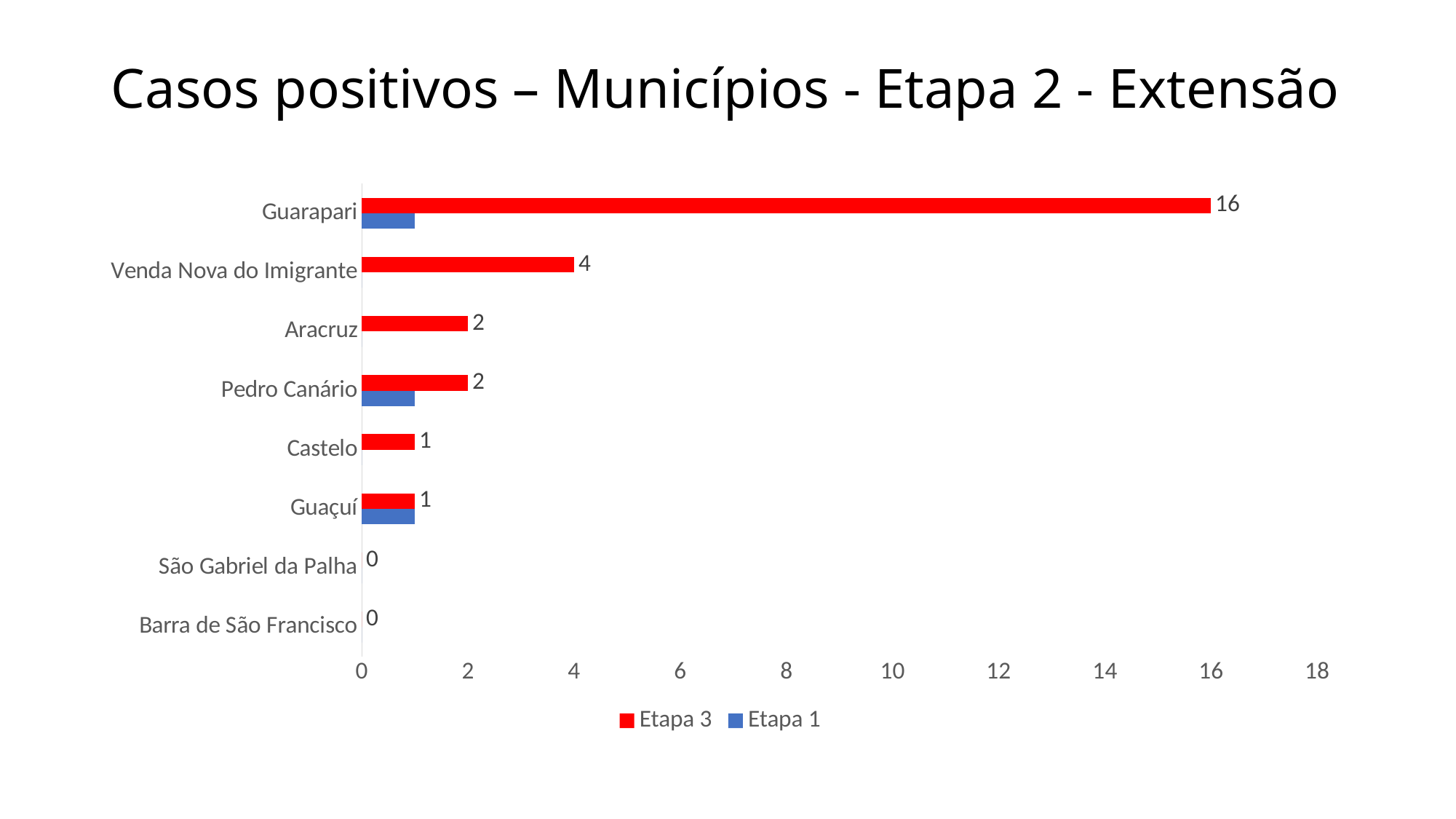
How many municipalities are shown on the chart? 8 Which municipality has the highest Etapa 3 value? Guarapari Is the Etapa 1 value for Guarapari greater or less than 2? less Is the Etapa 3 value for Guarapari greater or less than 14? greater What is the Etapa 3 value for Castelo? 1 What kind of chart is shown on the slide? Bar chart Which colour represents Etapa 1 in the chart? Blue What is the Etapa 3 value for Venda Nova do Imigrante? 4 What is the Etapa 3 value for Guarapari? 16 Which has a larger Etapa 3 value, Aracruz or Guaçuí? Aracruz What is the difference between the Etapa 3 values for Guarapari and Venda Nova do Imigrante? 12 How many series does the legend list? 2